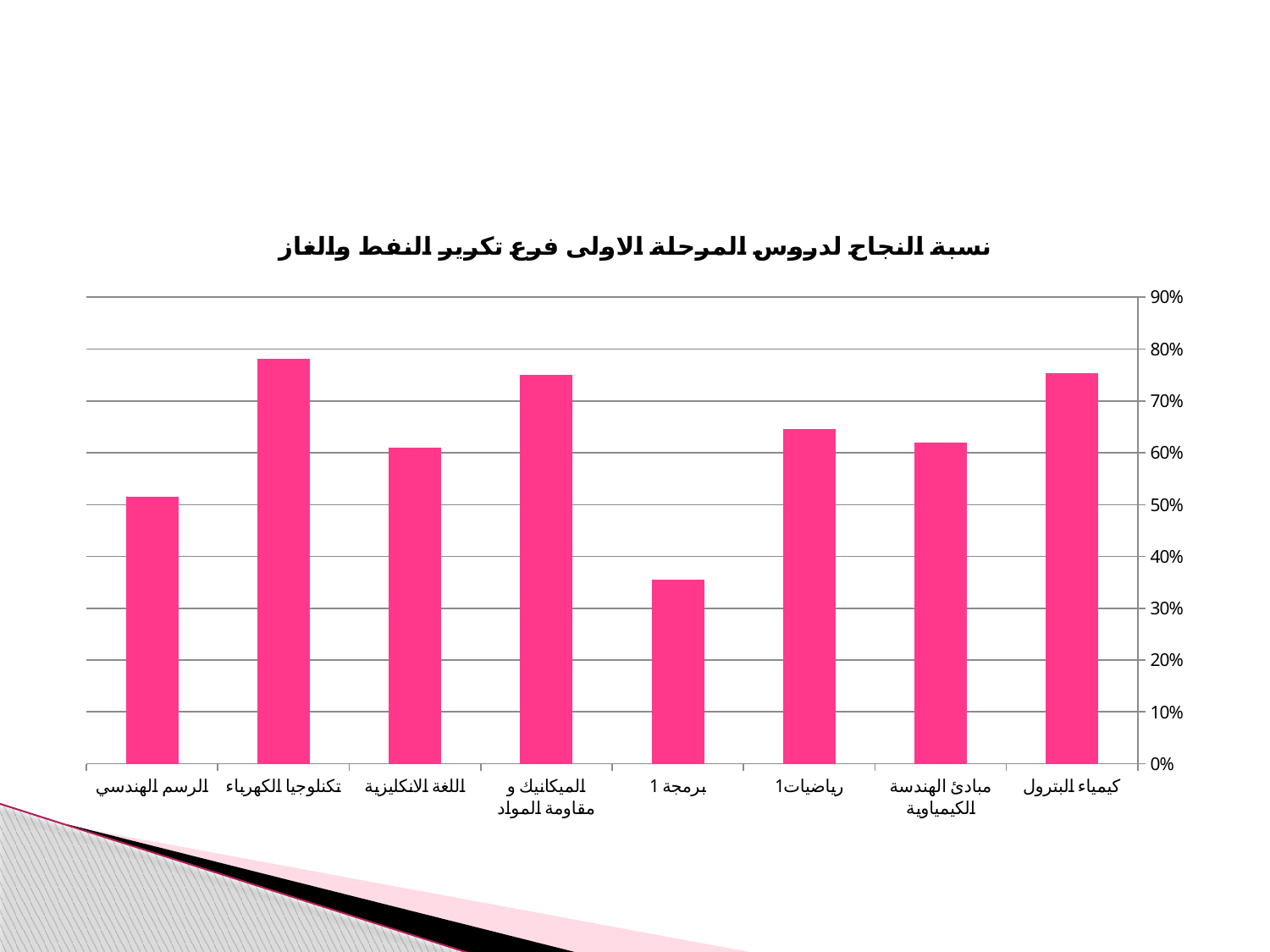
Which has the higher success rate, برمجة 1 or الرسم الهندسي? الرسم الهندسي Which has the higher success rate, اللغة الانكليزية or تكنلوجيا الكهرباء? تكنلوجيا الكهرباء Is the value for كيمياء البترول greater or less than 70%? greater Which subject has the lowest success rate on the chart? برمجة 1 What is the title of the chart? نسبة النجاح لدروس المرحلة الاولى فرع تكرير النفط والغاز What kind of chart is shown on the slide? bar chart Is the value for الرسم الهندسي greater or less than 60%? less Is the value for مبادئ الهندسة الكيمياوية greater or less than 70%? less How many subjects (categories) are plotted on the chart? 8